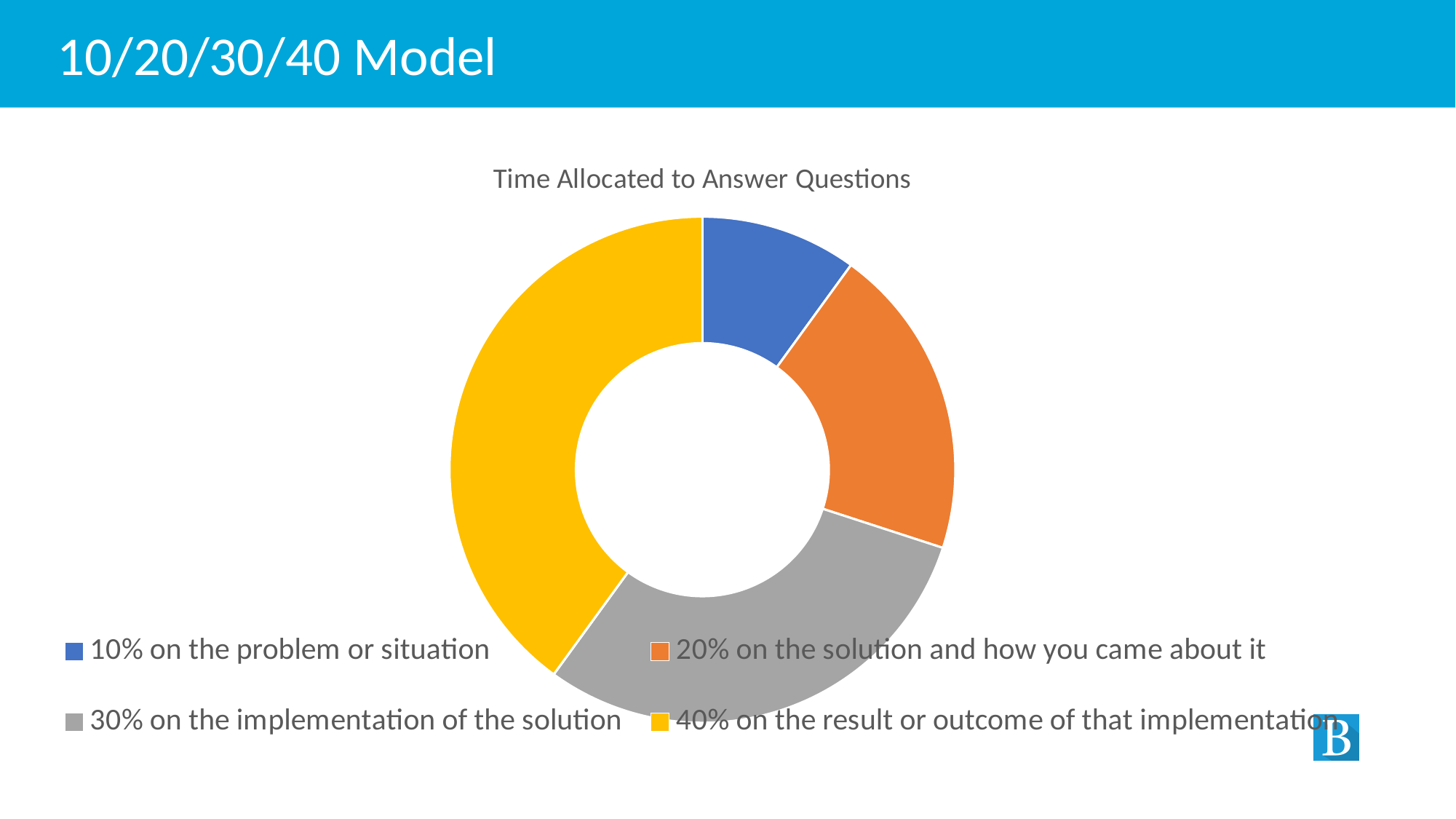
How many slices does the chart have? 4 Which category has the largest share of the chart? 40% on the result or outcome of that implementation What percentage of time is allocated to the solution and how you came about it? 20% What percentage of time is allocated to the result or outcome of that implementation? 40% What percentage of time is allocated to the problem or situation? 10% What is the difference between the share for the result or outcome and the share for the problem or situation? 30% What is the title of the chart? Time Allocated to Answer Questions Which category has the smallest share of the chart? 10% on the problem or situation Which is larger: the share for the implementation of the solution or the share for the solution and how you came about it? the implementation of the solution What kind of chart is shown on the slide? doughnut chart What colour is the slice for the result or outcome of that implementation? yellow What percentage of time is allocated to the implementation of the solution? 30%